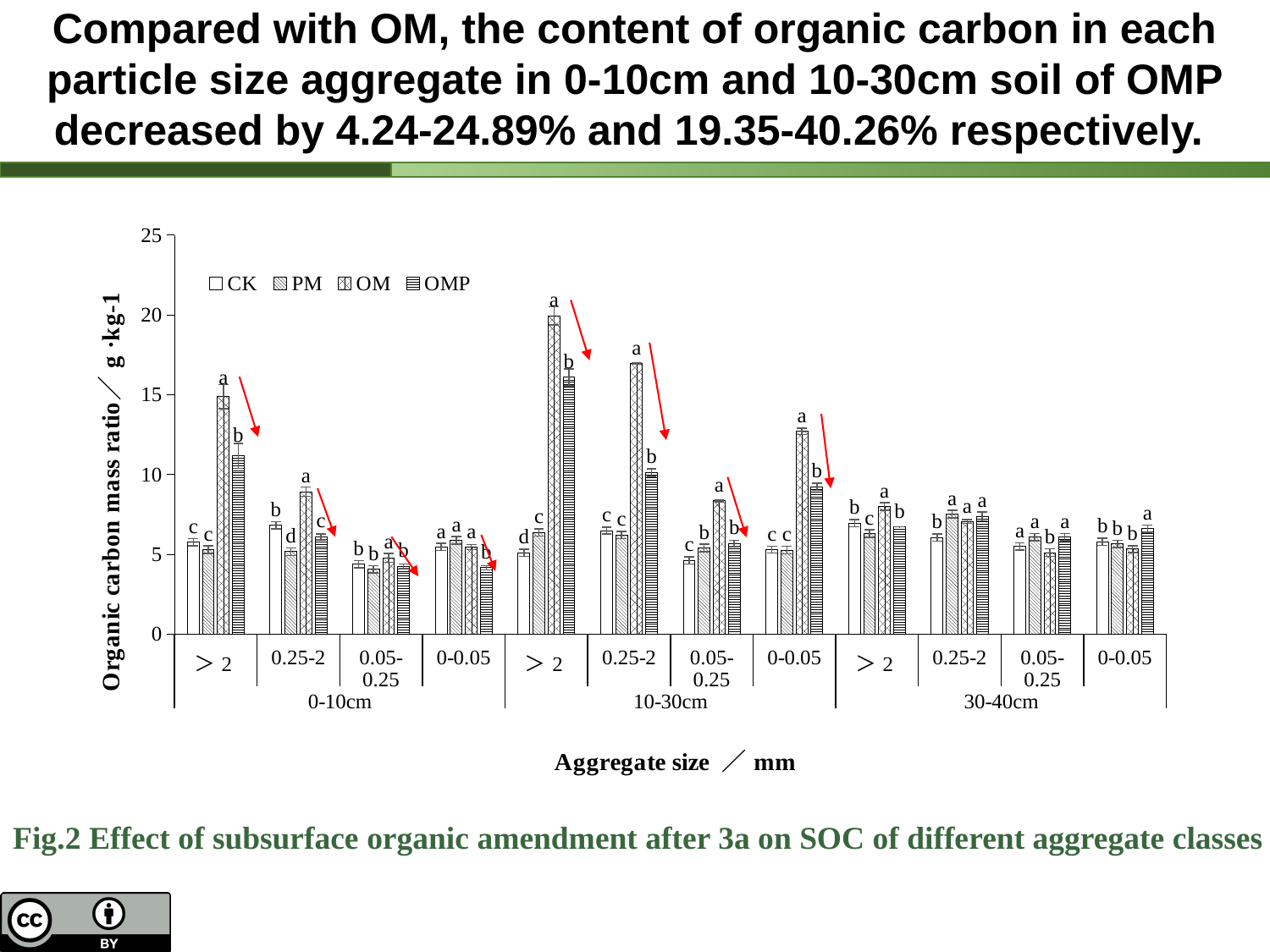
Which series has the highest bar in the >2 mm group of the 10-30cm depth? OM How many aggregate size classes are shown within each soil depth group? 4 In the 0.05-0.25 mm group of the 10-30cm depth, which is larger, the OM bar or the CK bar? OM What is the label of the x axis? Aggregate size / mm In the 0.25-2 mm group of the 10-30cm depth, which is larger, the OM bar or the OMP bar? OM How many series does the legend list? 4 What are the series names listed in the legend? CK, PM, OM, OMP Is the OM value for the >2 mm aggregate in the 0-10cm depth greater or less than 10? greater Is the OM value for the >2 mm aggregate in the 10-30cm depth greater or less than 15? greater How many soil depth groups are shown along the x axis? 3 Is the OM value for the 0-0.05 mm aggregate in the 10-30cm depth greater or less than 10? greater What kind of chart is shown on the slide? bar chart